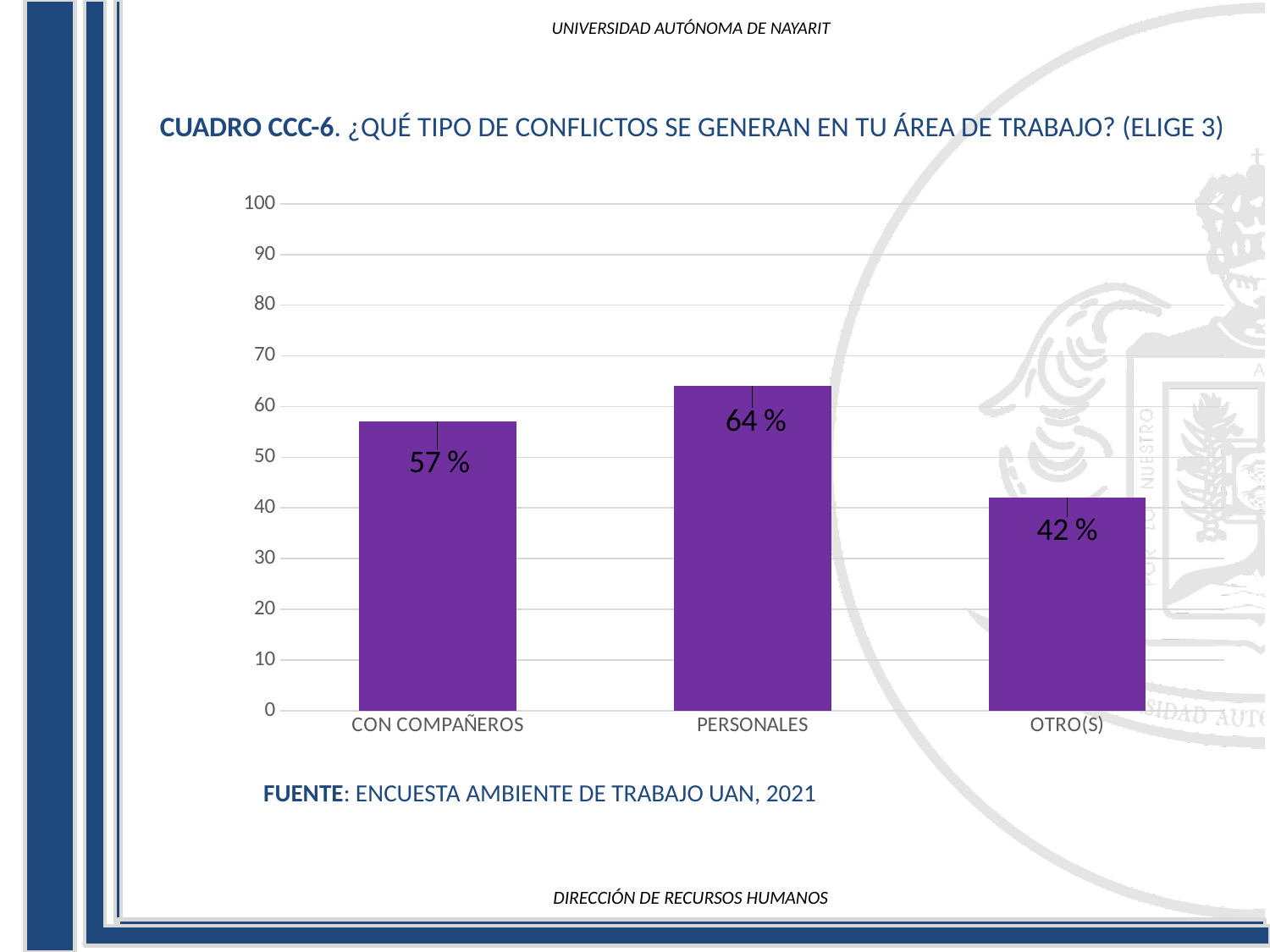
What is the value for OTRO(S)? 42 % What is the difference between the values for PERSONALES and CON COMPAÑEROS? 7 % Which category has the lowest value? OTRO(S) Is the value for PERSONALES greater or less than 60? greater What is the difference between the values for CON COMPAÑEROS and OTRO(S)? 15 % What kind of chart is shown on the slide? bar chart How many categories are shown on the chart? 3 What is the value for PERSONALES? 64 % What source is cited below the chart? ENCUESTA AMBIENTE DE TRABAJO UAN, 2021 Which is larger, the value for CON COMPAÑEROS or the value for OTRO(S)? CON COMPAÑEROS Which category has the highest value? PERSONALES What is the value for CON COMPAÑEROS? 57 %